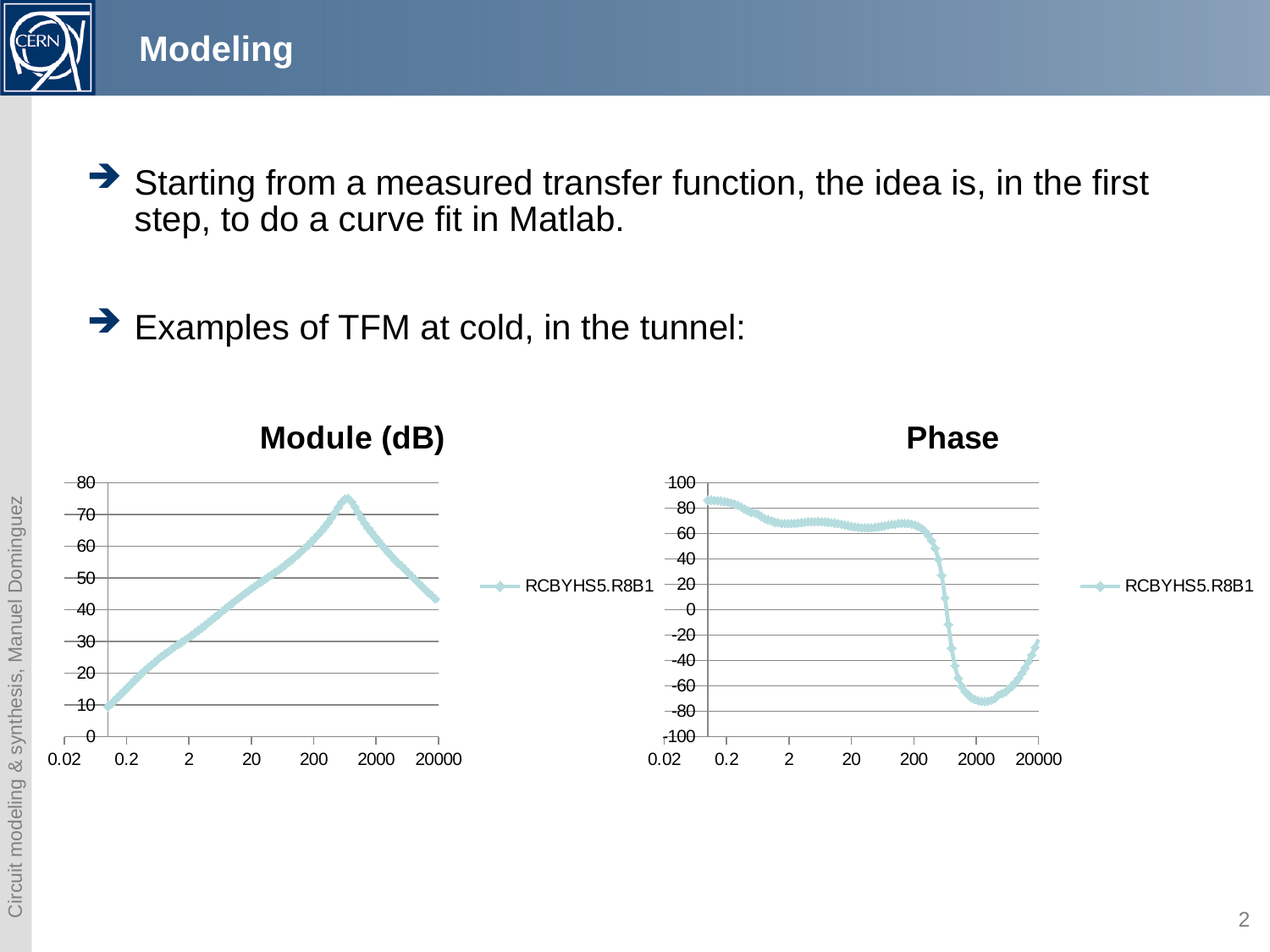
In the Phase chart, is the value at 20000 greater or less than 0? less What is the name of the series shown in the Phase chart's legend? RCBYHS5.R8B1 In the Module (dB) chart, is the value at 2 greater or less than 20? greater How many series does the legend of the Module (dB) chart list? 1 In the Module (dB) chart, is the highest value of the curve greater or less than 70? greater What kind of chart is the Phase chart? line chart In the Phase chart, do the values rise or fall along the x axis between 200 and 2000? fall What kind of chart is the Module (dB) chart? line chart In the Phase chart, which is larger: the value at 0.2 or the value at 2000? the value at 0.2 In the Module (dB) chart, do the values rise or fall along the x axis between 0.2 and 200? rise